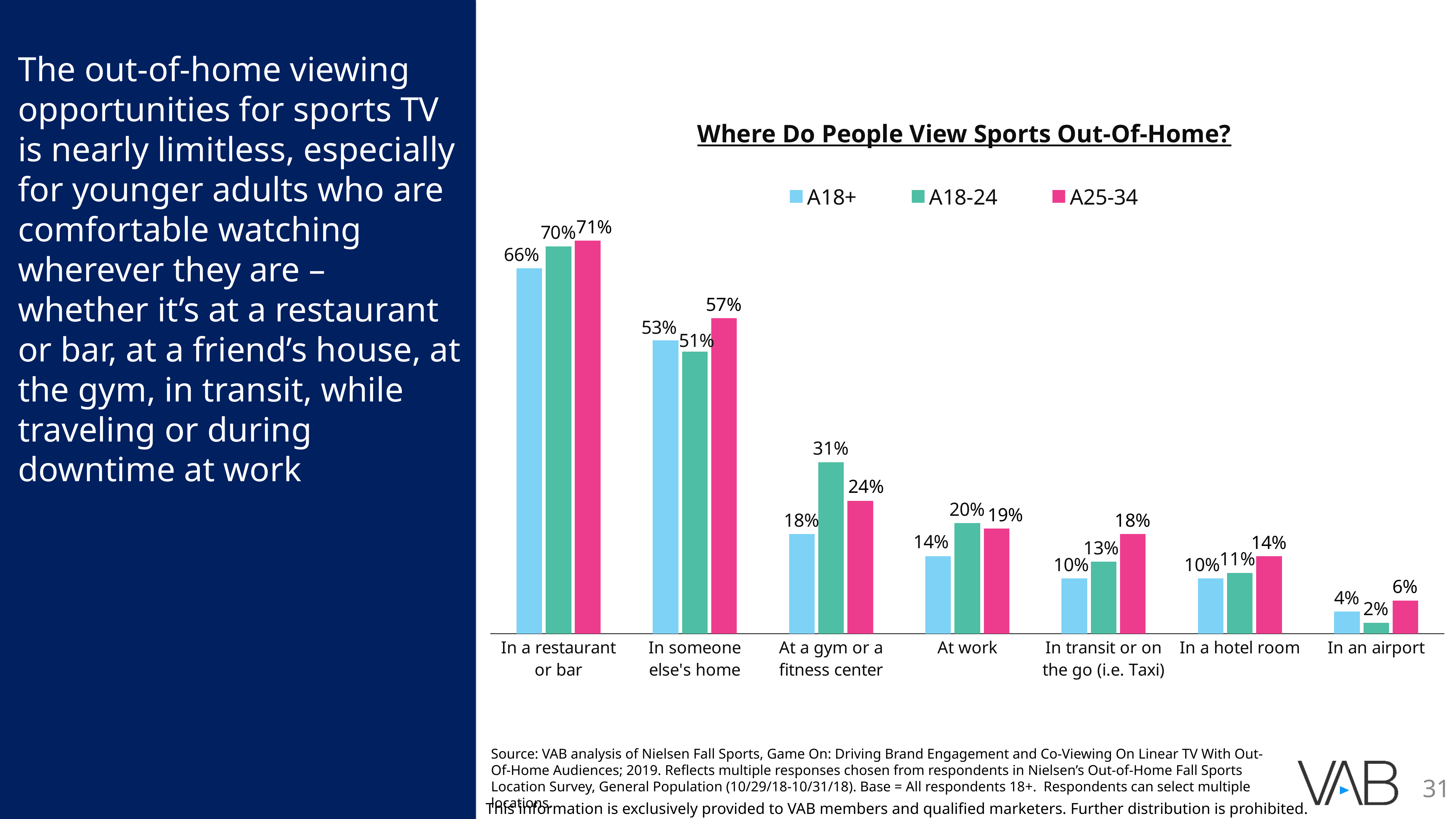
Which is larger at work: the A18-24 value or the A25-34 value? A18-24 What is the difference between the A25-34 and A18+ values for 'In transit or on the go (i.e. Taxi)'? 8% What is the value for A25-34 in the 'In someone else's home' category? 57% What kind of chart is shown on the slide? Bar chart Which category has the lowest value for the A18-24 series? In an airport How many location categories are shown on the x axis? 7 Do the A18+ values generally rise or fall moving from left to right along the x axis? Fall What is the title of the chart? Where Do People View Sports Out-Of-Home? Which category has the highest value for the A25-34 series? In a restaurant or bar How many series does the legend list? 3 What is the value for A18+ in the 'In a restaurant or bar' category? 66% What is the value for A18-24 at a gym or a fitness center? 31%